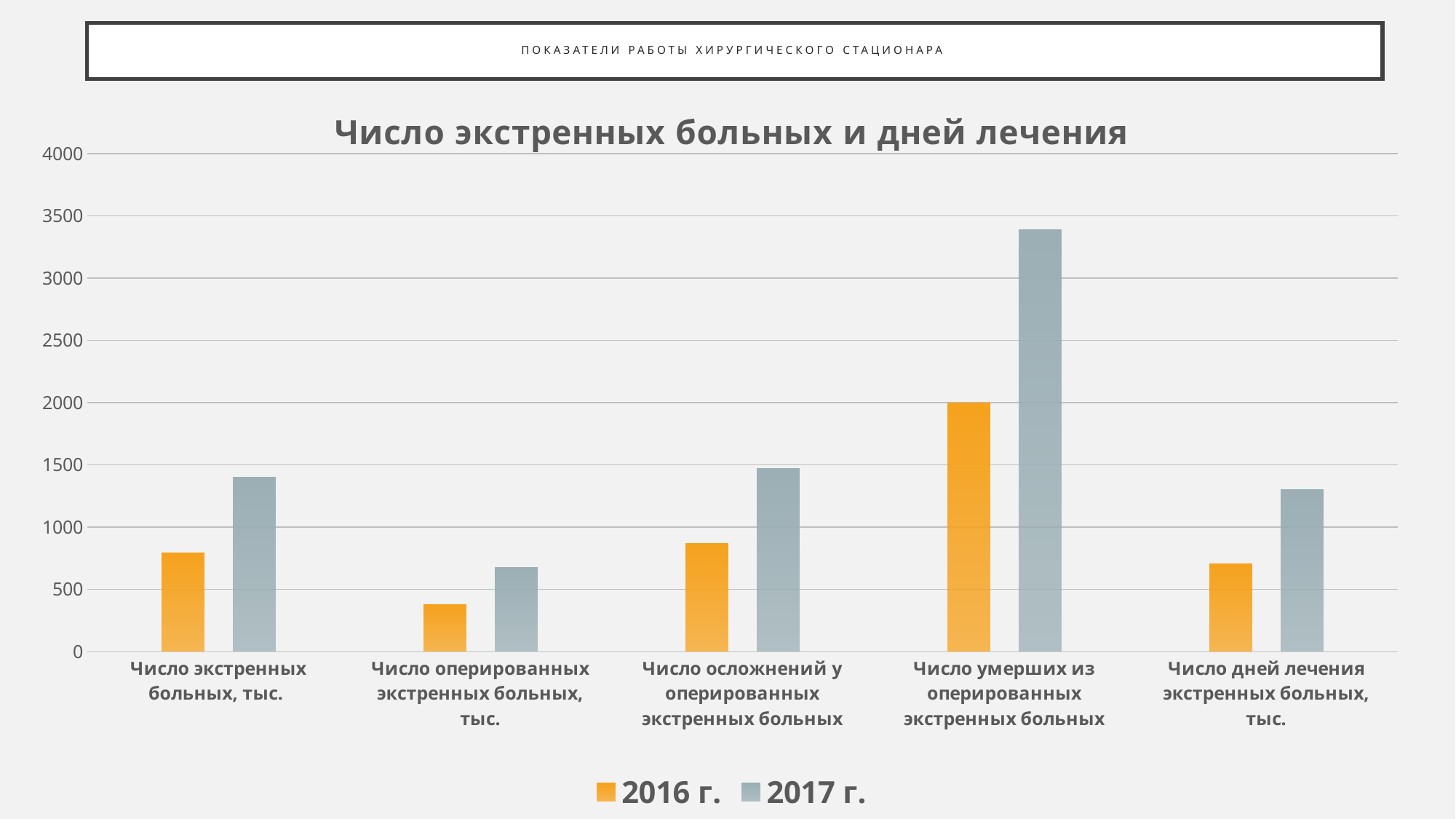
For Число осложнений у оперированных экстренных больных, which series has the larger value, 2016 г. or 2017 г.? 2017 г. Which category has the lowest bar in the chart? Число оперированных экстренных больных, тыс. Is the 2017 г. value for Число дней лечения экстренных больных, тыс. greater or less than 1000? greater How many categories are shown on the x axis? 5 Which category has the highest bar in the chart? Число умерших из оперированных экстренных больных How many series does the legend list? 2 Is the 2016 г. value for Число оперированных экстренных больных, тыс. greater or less than 500? less What is the title of the chart? Число экстренных больных и дней лечения Is the 2016 г. value for Число экстренных больных, тыс. greater or less than 1000? less What kind of chart is shown on the slide? bar chart